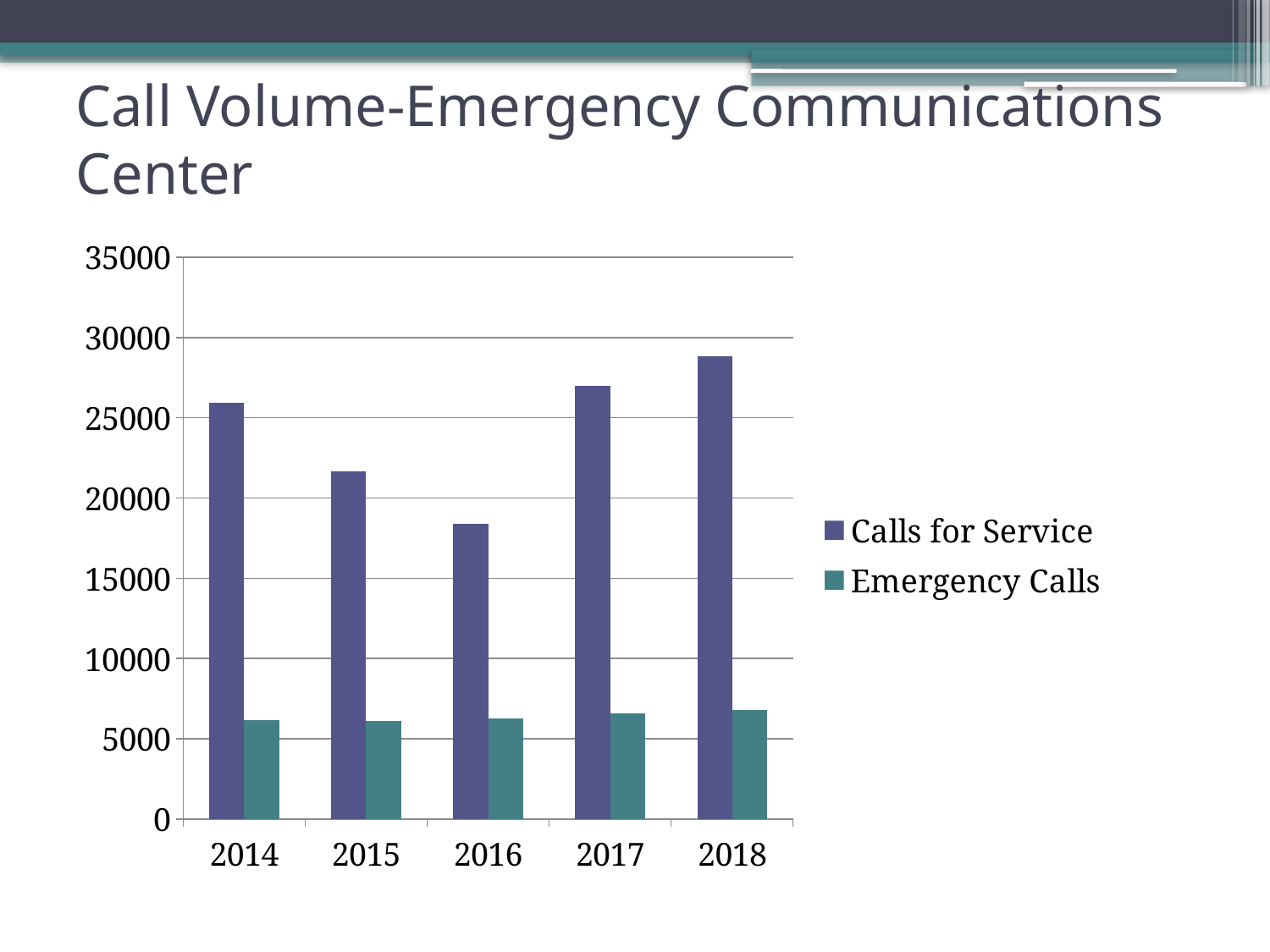
Is the value for Calls for Service in 2014 greater or less than 25000? greater Is the value for Calls for Service in 2016 greater or less than 20000? less Which is larger, Calls for Service in 2014 or Calls for Service in 2015? 2014 How many series does the legend list? 2 Is the value for Emergency Calls in 2018 greater or less than 5000? greater How many years are shown on the x axis? 5 What is the title of the slide containing the chart? Call Volume-Emergency Communications Center What kind of chart is shown on the slide? bar chart Which year has the lowest value for Calls for Service? 2016 Which is larger, Calls for Service in 2017 or Calls for Service in 2018? 2018 Which year has the highest value for Calls for Service? 2018